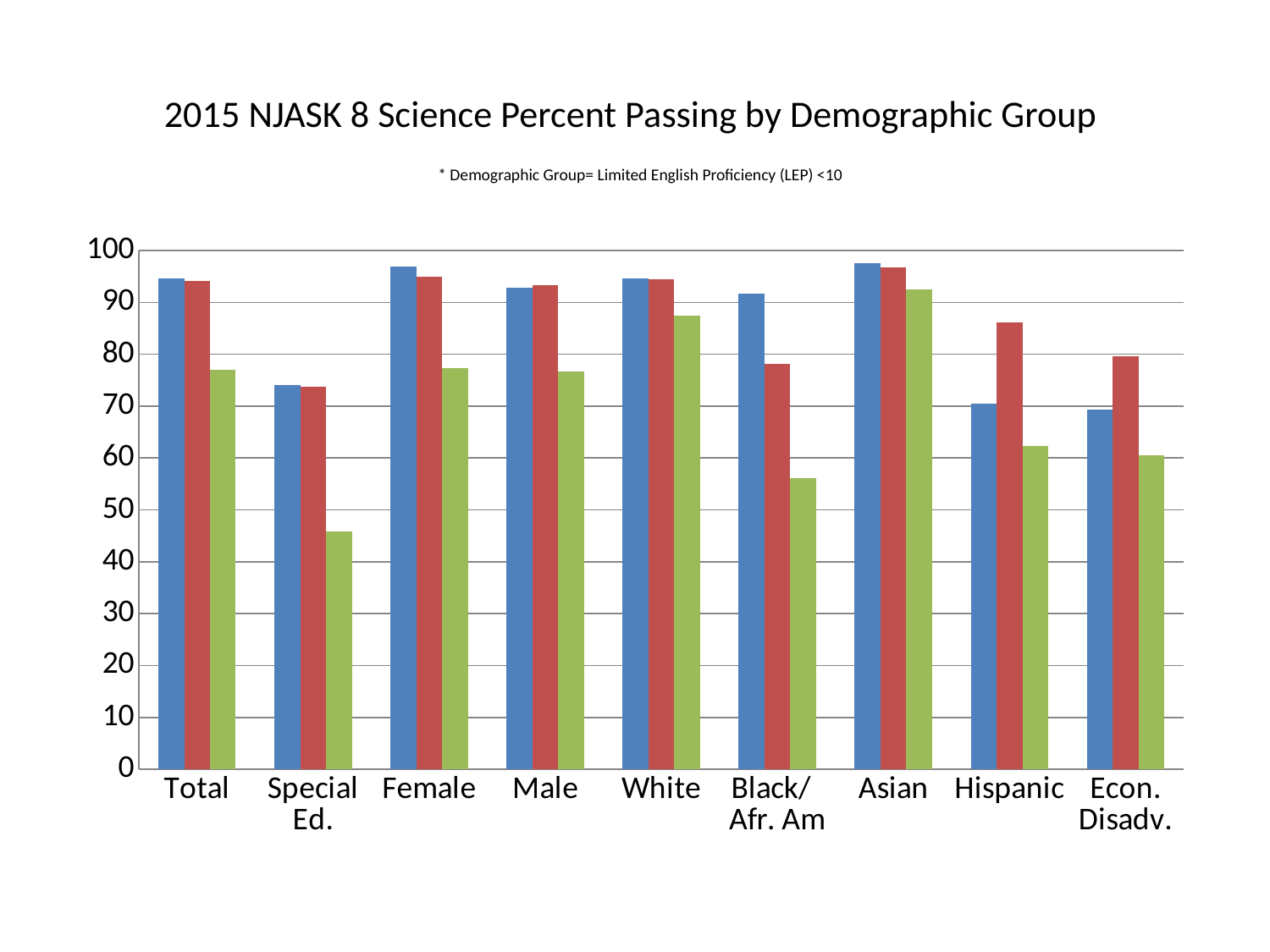
Is the green bar for White greater or less than 80? greater What is the title of the chart? 2015 NJASK 8 Science Percent Passing by Demographic Group Is the blue bar for Asian greater or less than 90? greater Is the green bar for Black/Afr. Am greater or less than 50? greater Which demographic group has the highest green bar? Asian How many demographic groups are shown along the x axis? 9 How many bars are plotted for each demographic group? 3 What kind of chart is shown on the slide? bar chart Which is larger, the green bar for Black/Afr. Am or the green bar for Hispanic? Hispanic Which demographic group has the lowest green bar? Special Ed.